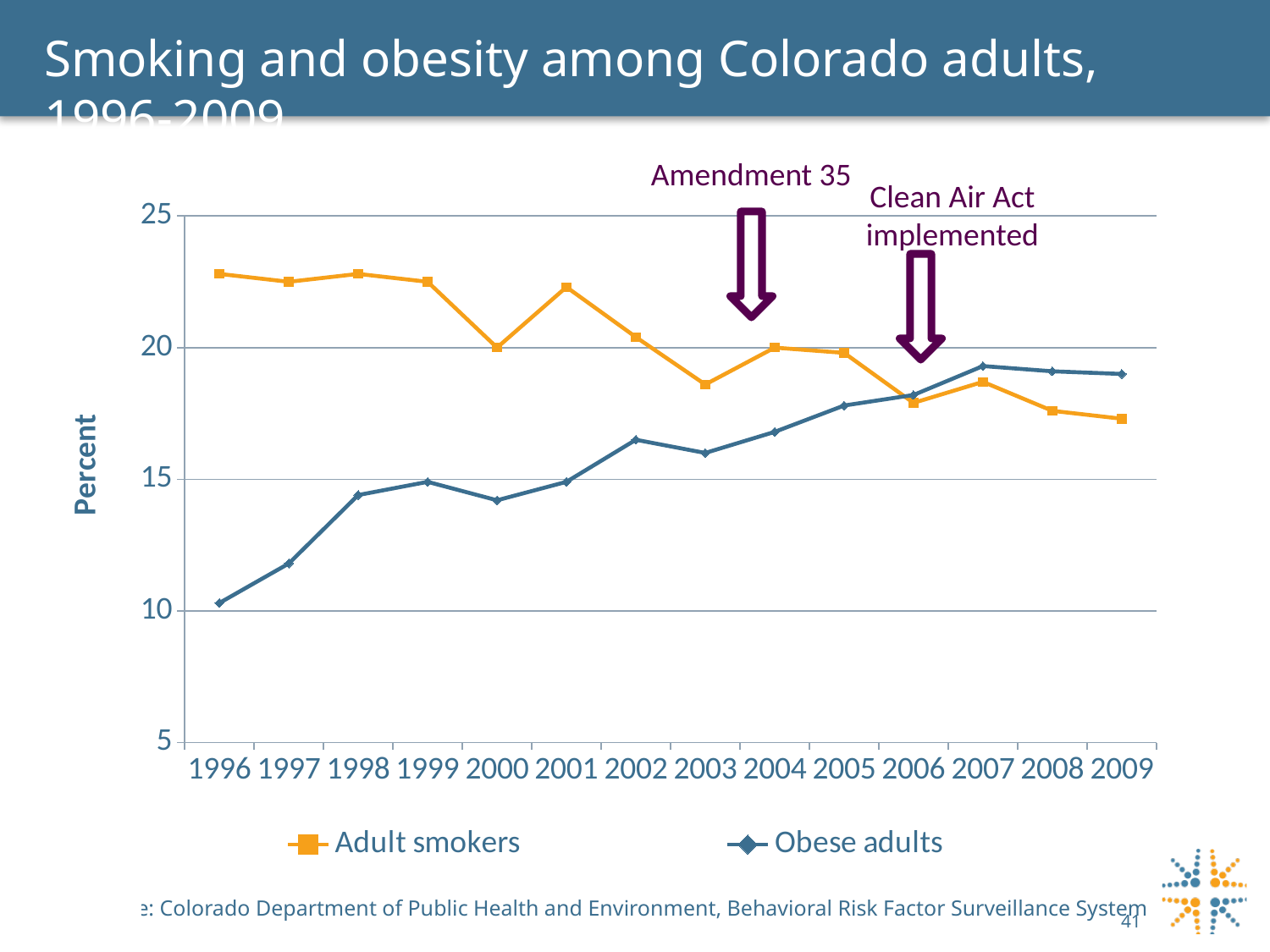
What is the label on the vertical axis? Percent Does the Obese adults series generally rise or fall from 1996 to 2009? Rise In 2009, which series has the higher value, Adult smokers or Obese adults? Obese adults In 1996, which series has the higher value, Adult smokers or Obese adults? Adult smokers Is the value for Adult smokers in 2009 greater or less than 20? less Is the value for Obese adults in 2009 greater or less than 20? less What kind of chart is shown on the slide? Line chart How many years are plotted along the x axis? 14 How many series does the legend list? 2 In which year is the Obese adults series at its lowest? 1996 Is the value for Adult smokers in 1996 greater or less than 20? greater